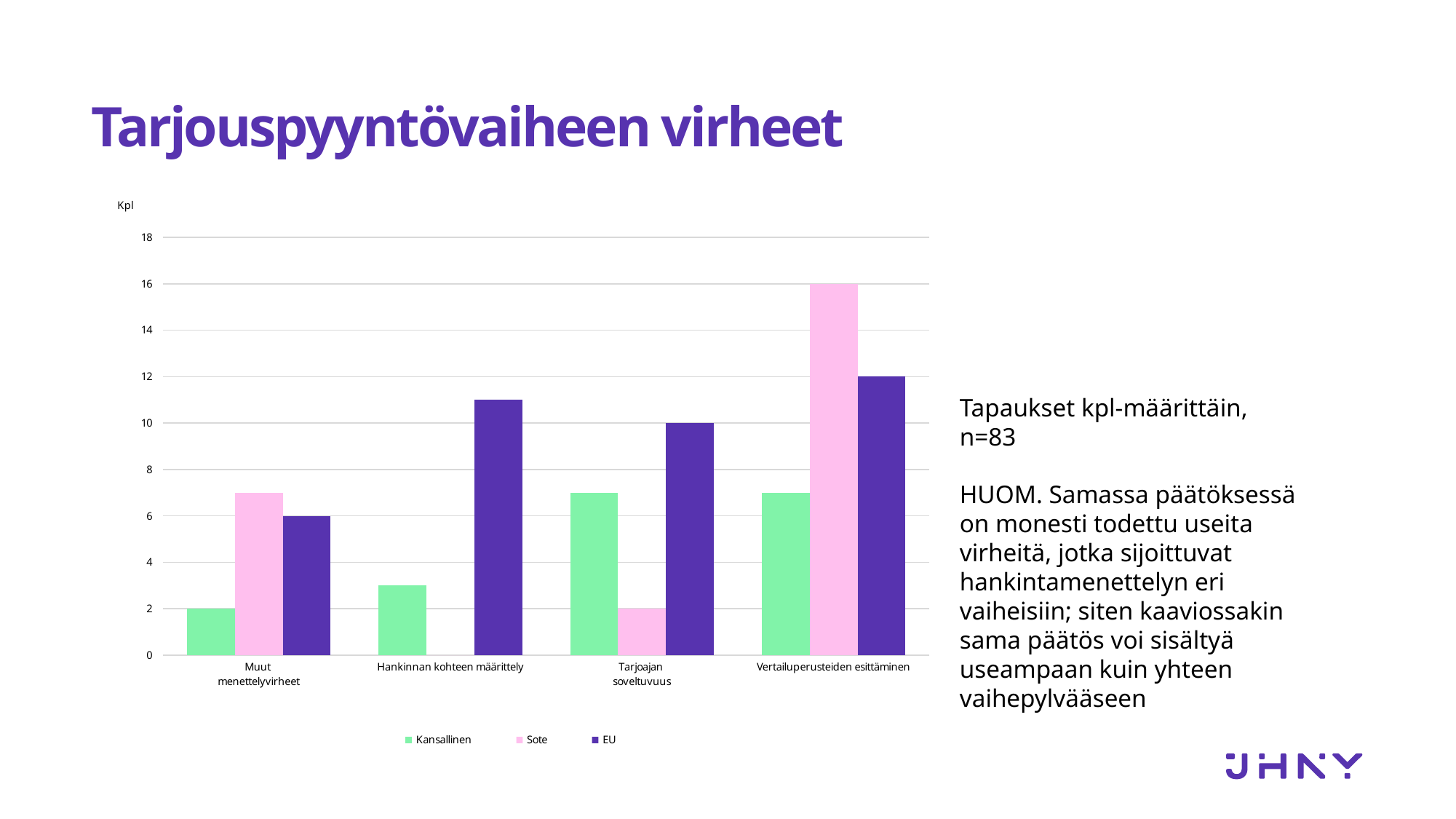
Which is larger for Tarjoajan soveltuvuus, the Kansallinen value or the Sote value? Kansallinen What is the Sote value for Vertailuperusteiden esittäminen? 16 What kind of chart is shown on the slide? bar chart Is the EU value for Hankinnan kohteen määrittely greater or less than 10? greater How many series does the legend list? 3 What is the difference between the Sote and EU values for Vertailuperusteiden esittäminen? 4 What is the EU value for Tarjoajan soveltuvuus? 10 How many categories are shown on the x axis? 4 Which category has the highest Sote value? Vertailuperusteiden esittäminen What is the EU value for Vertailuperusteiden esittäminen? 12 What is the Kansallinen value for Muut menettelyvirheet? 2 Which category has the lowest EU value? Muut menettelyvirheet